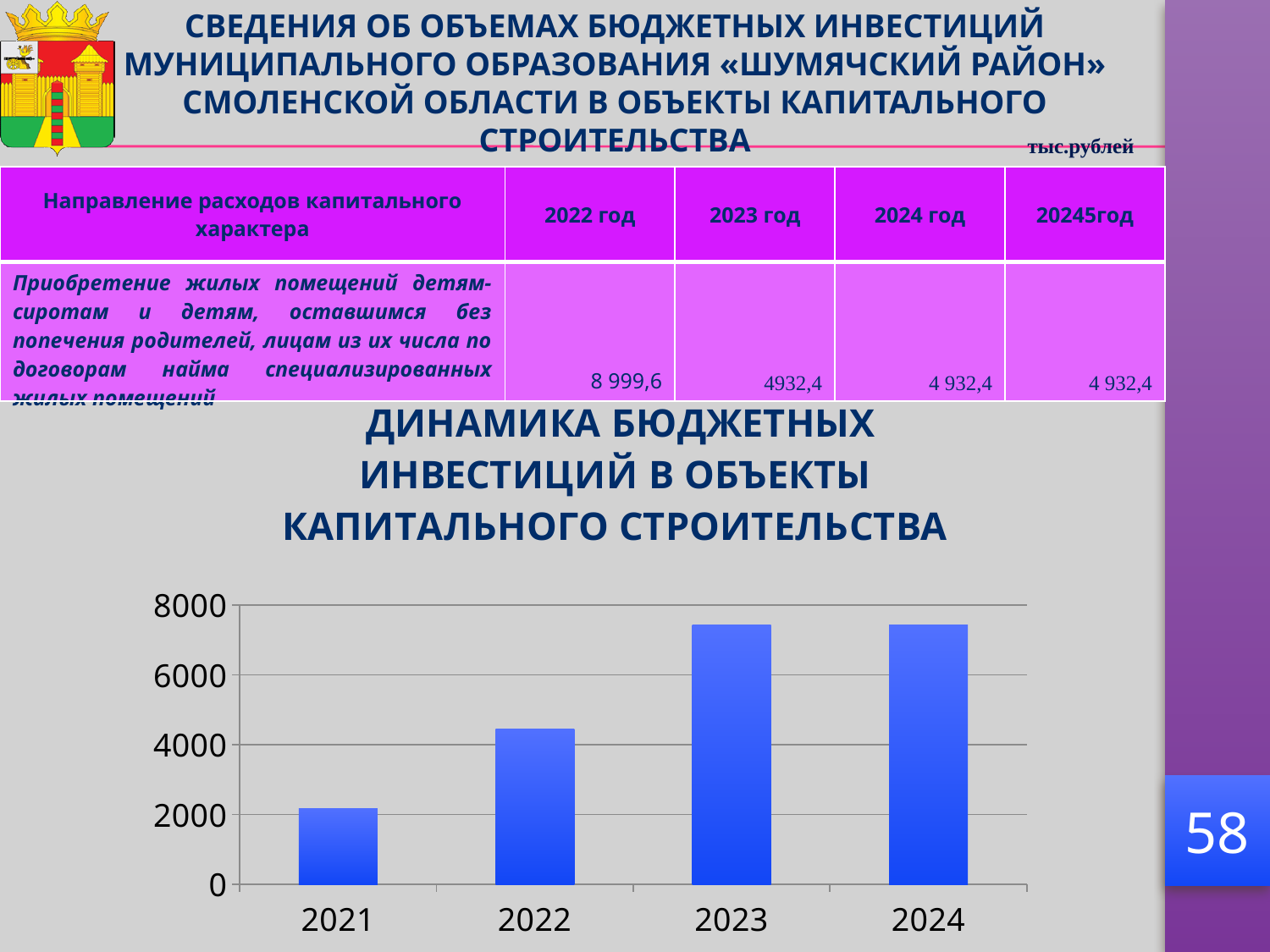
Do the values generally rise or fall from 2021 to 2024? rise Which is larger, the value for 2021 or the value for 2022? 2022 What is the highest value shown on the y axis of the chart? 8000 Is the value for 2024 greater or less than 8000? less What kind of chart is shown on the slide? bar chart Is the value for 2023 greater or less than 6000? greater Is the value for 2021 greater or less than 4000? less What is the title of the chart? ДИНАМИКА БЮДЖЕТНЫХ ИНВЕСТИЦИЙ В ОБЪЕКТЫ КАПИТАЛЬНОГО СТРОИТЕЛЬСТВА How many years are shown on the x axis of the chart? 4 Which year has the lowest bar in the chart? 2021 Which is larger, the value for 2022 or the value for 2023? 2023